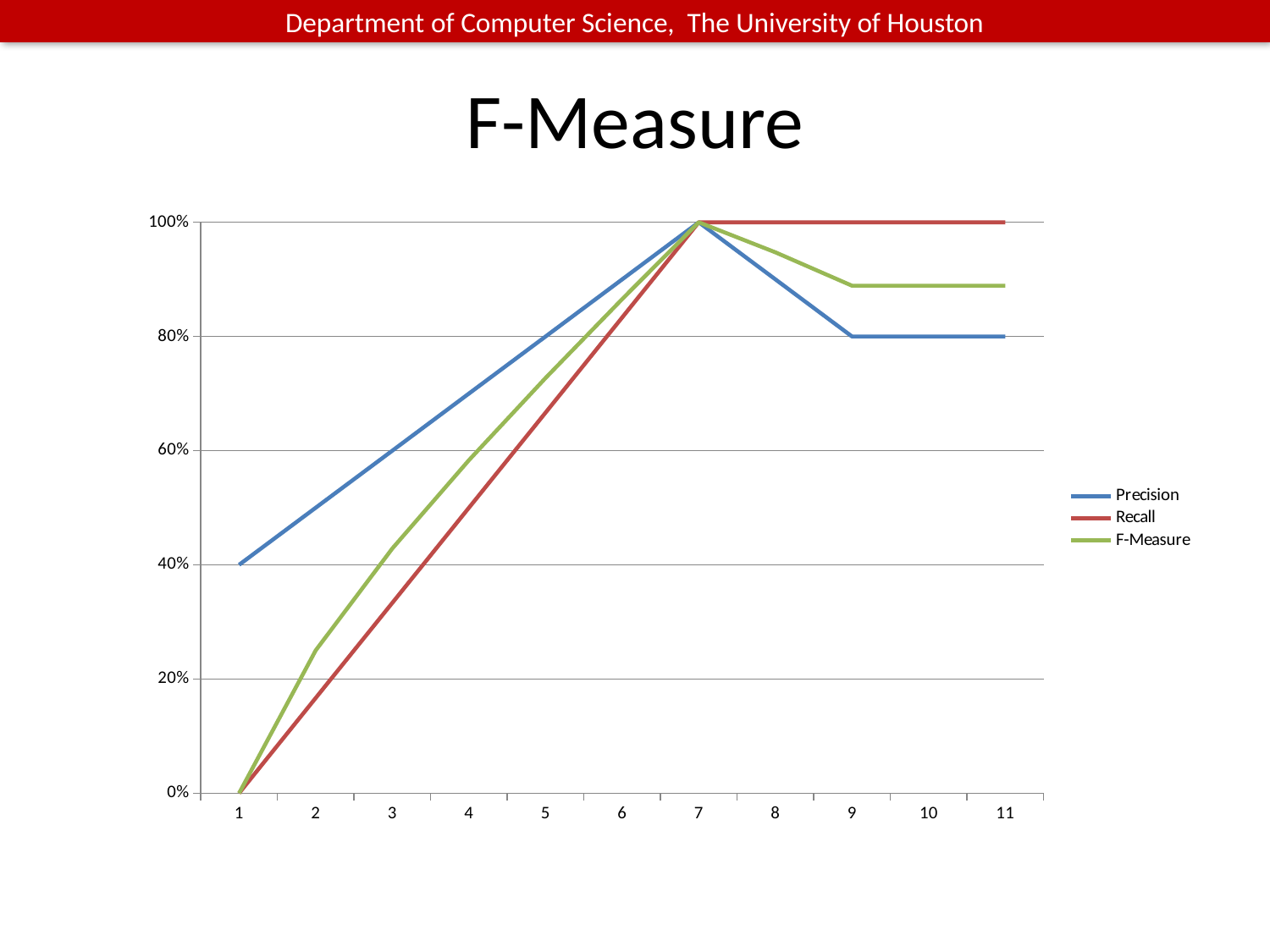
How many points are labelled along the x axis? 11 Does the Recall line rise or fall from x = 1 to x = 7? rise What is the difference between Recall and Precision at x = 11? 20% At x = 4, which is larger, Precision or Recall? Precision Is the F-Measure value at x = 11 greater or less than 80%? greater Is the F-Measure value at x = 2 greater or less than 40%? less How many series does the legend list? 3 What is the Precision value at x = 11? 80% What is the Precision value at x = 1? 40% What kind of chart is shown on the slide? line chart What is the Recall value at x = 11? 100% Which series has the highest value at x = 11? Recall